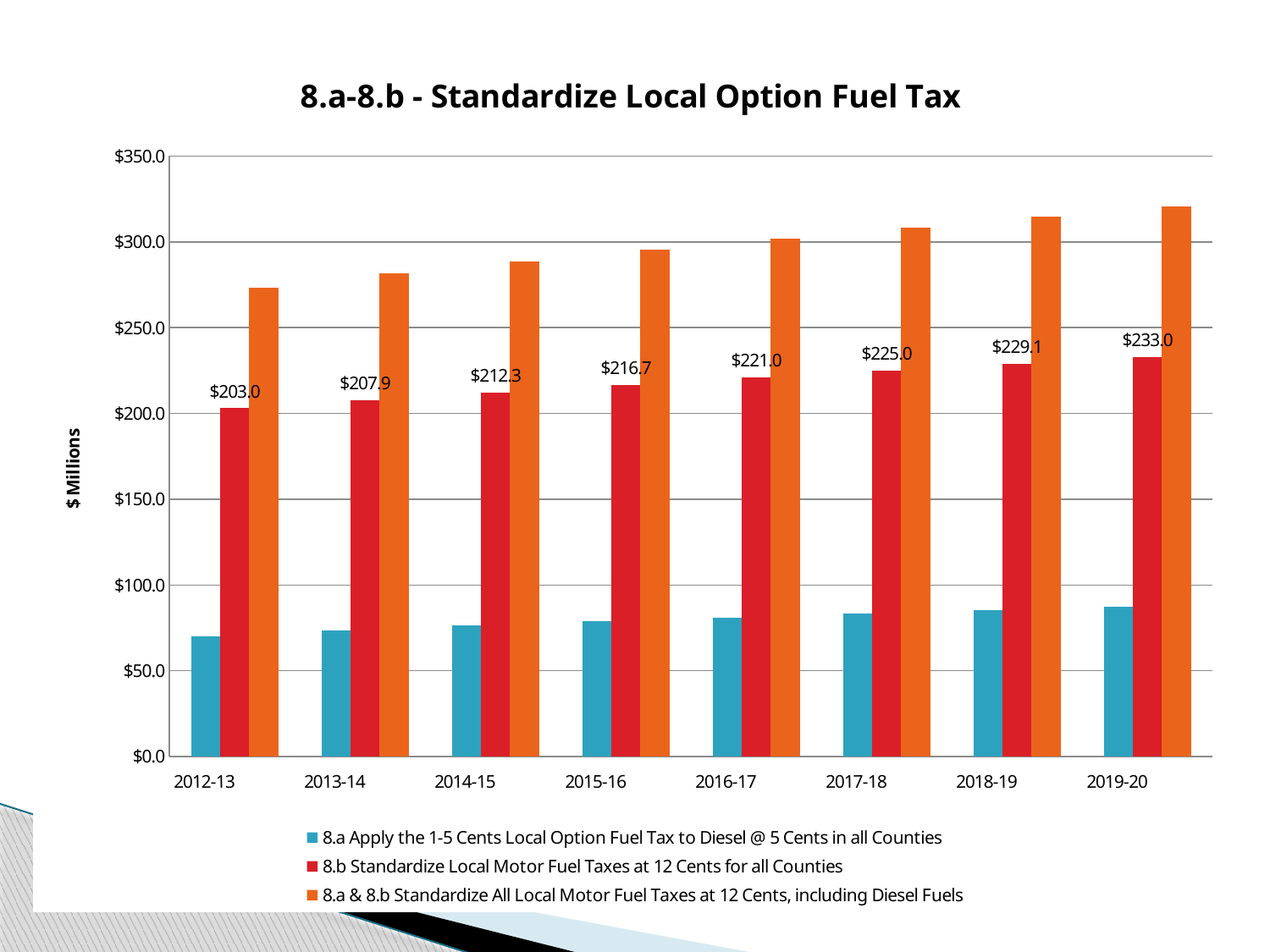
What is the difference between the 8.b series values for 2019-20 and 2012-13? $30.0 Is the value for the 8.a & 8.b series in 2019-20 greater or less than $300.0? greater How many years are shown on the x axis? 8 What is the value for 8.b Standardize Local Motor Fuel Taxes at 12 Cents for all Counties in 2016-17? $221.0 Which is larger for 2015-16: the 8.b series or the 8.a & 8.b series? 8.a & 8.b Standardize All Local Motor Fuel Taxes at 12 Cents, including Diesel Fuels In which year is the 8.b Standardize Local Motor Fuel Taxes at 12 Cents for all Counties series lowest? 2012-13 Does the 8.b series rise or fall from 2012-13 to 2019-20? rise How many series does the legend list? 3 In which year is the 8.b Standardize Local Motor Fuel Taxes at 12 Cents for all Counties series highest? 2019-20 Is the value for the 8.a series in 2012-13 greater or less than $100.0? less What is the value for 8.b Standardize Local Motor Fuel Taxes at 12 Cents for all Counties in 2019-20? $233.0 What is the value for 8.b Standardize Local Motor Fuel Taxes at 12 Cents for all Counties in 2012-13? $203.0